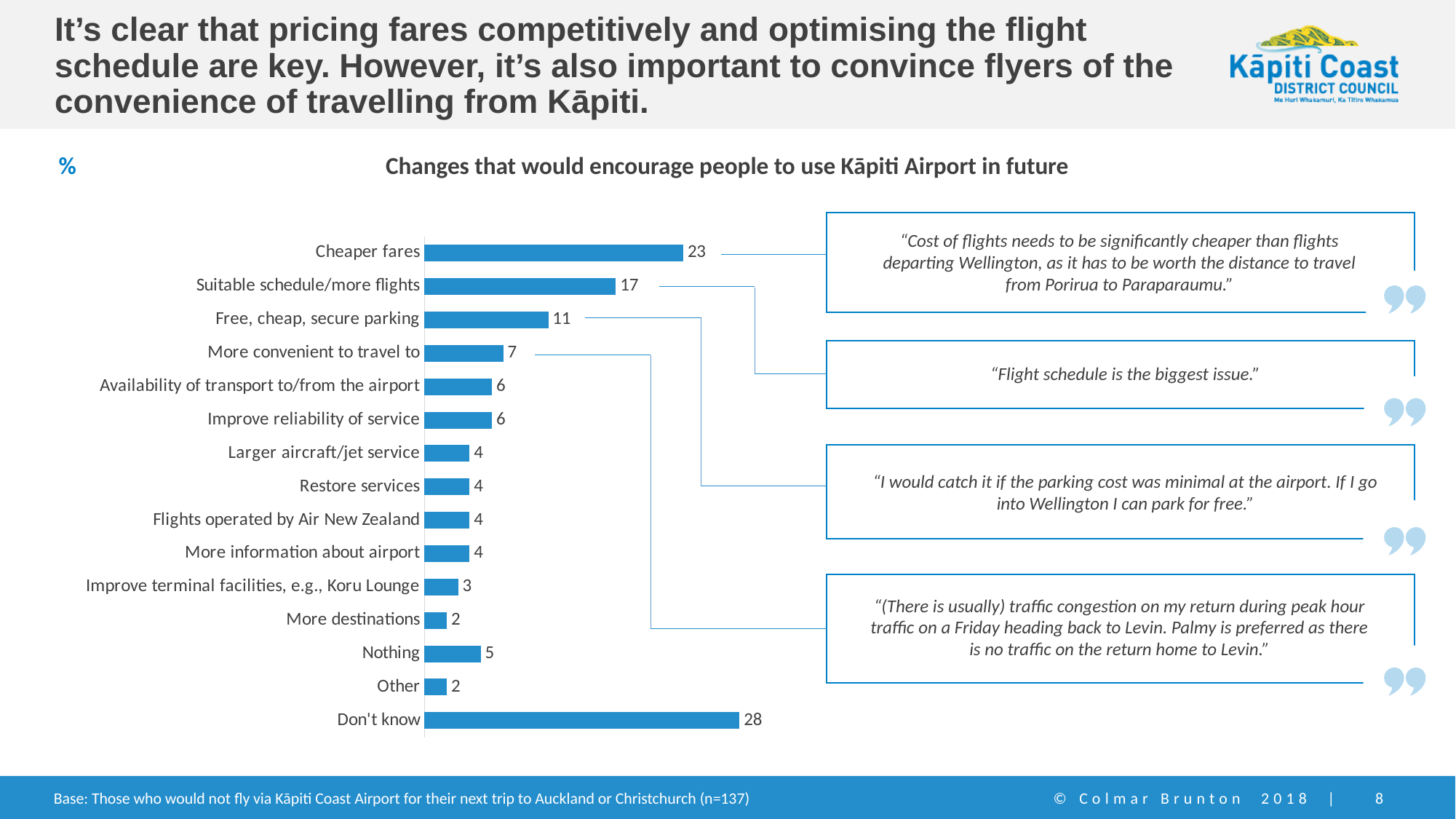
What type of chart is shown on the slide? Bar chart Which has a larger value: 'More convenient to travel to' or 'Improve reliability of service'? More convenient to travel to What is the title of the chart? Changes that would encourage people to use Kāpiti Airport in future What is the difference between the values for 'Cheaper fares' and 'Suitable schedule/more flights'? 6 What is the value for 'Nothing'? 5 Which category has the highest value in the chart? Don't know How many categories are shown in the chart? 15 Which has a larger value: 'Free, cheap, secure parking' or 'Nothing'? Free, cheap, secure parking What percentage of respondents said cheaper fares would encourage them to use Kāpiti Airport in future? 23 What is the value for 'Suitable schedule/more flights'? 17 What is the difference between the values for 'Don't know' and 'Cheaper fares'? 5 What is the value for 'Free, cheap, secure parking'? 11